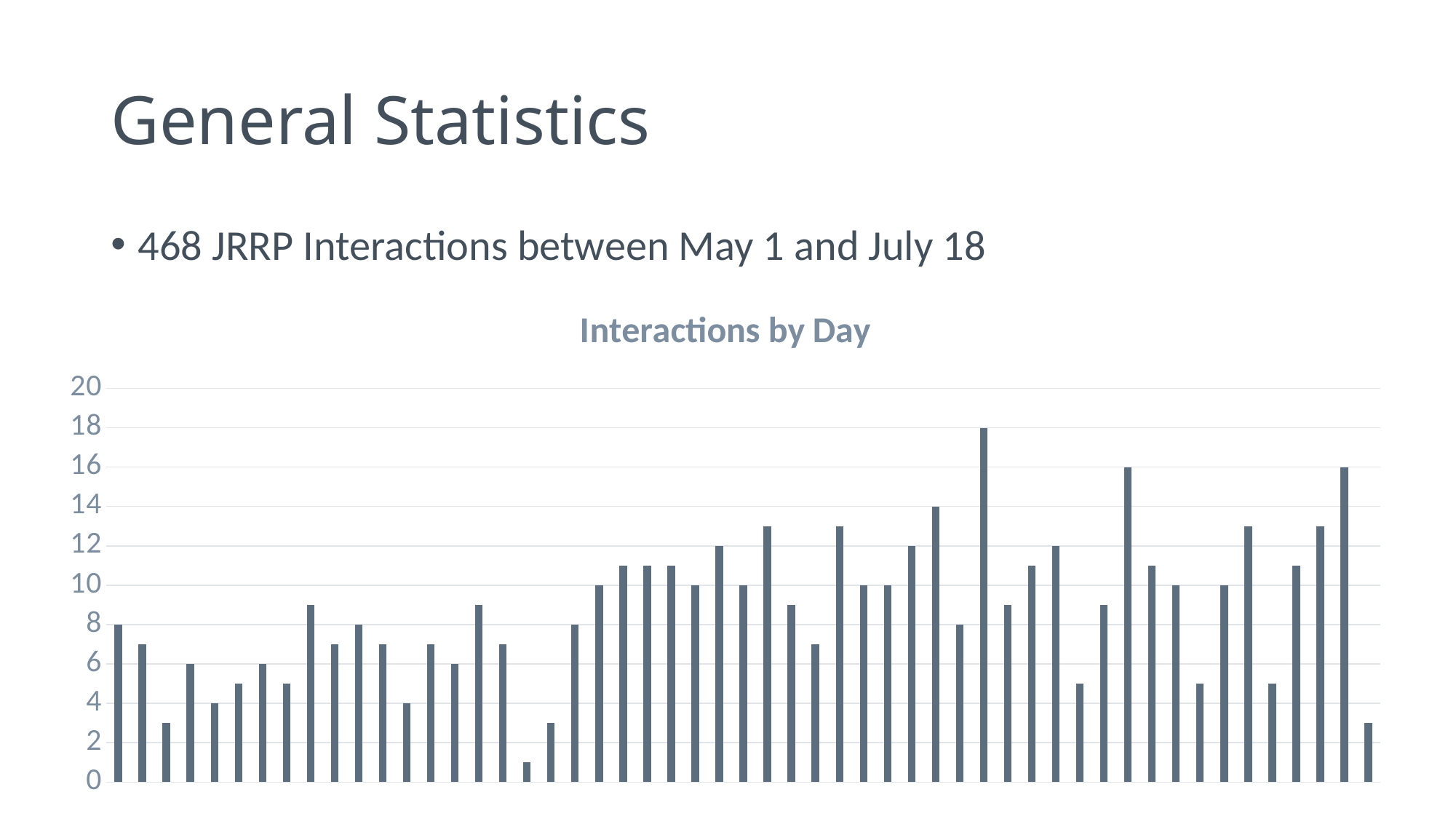
How many bars in the chart reach a value of 16 or more? 3 What is the highest value shown on the vertical axis of the chart? 20 What value does the tallest bar in the 'Interactions by Day' chart reach? 18 What value do the two second-tallest bars in the chart reach? 16 Do the daily interaction values generally rise or fall from left to right across the chart? rise What is the title of the chart on the slide? Interactions by Day Is the tallest bar in the chart greater or less than 16? greater Does any bar in the chart reach 20? No Is the first (leftmost) bar in the chart greater or less than 10? less What kind of chart is shown under the heading 'Interactions by Day'? bar chart